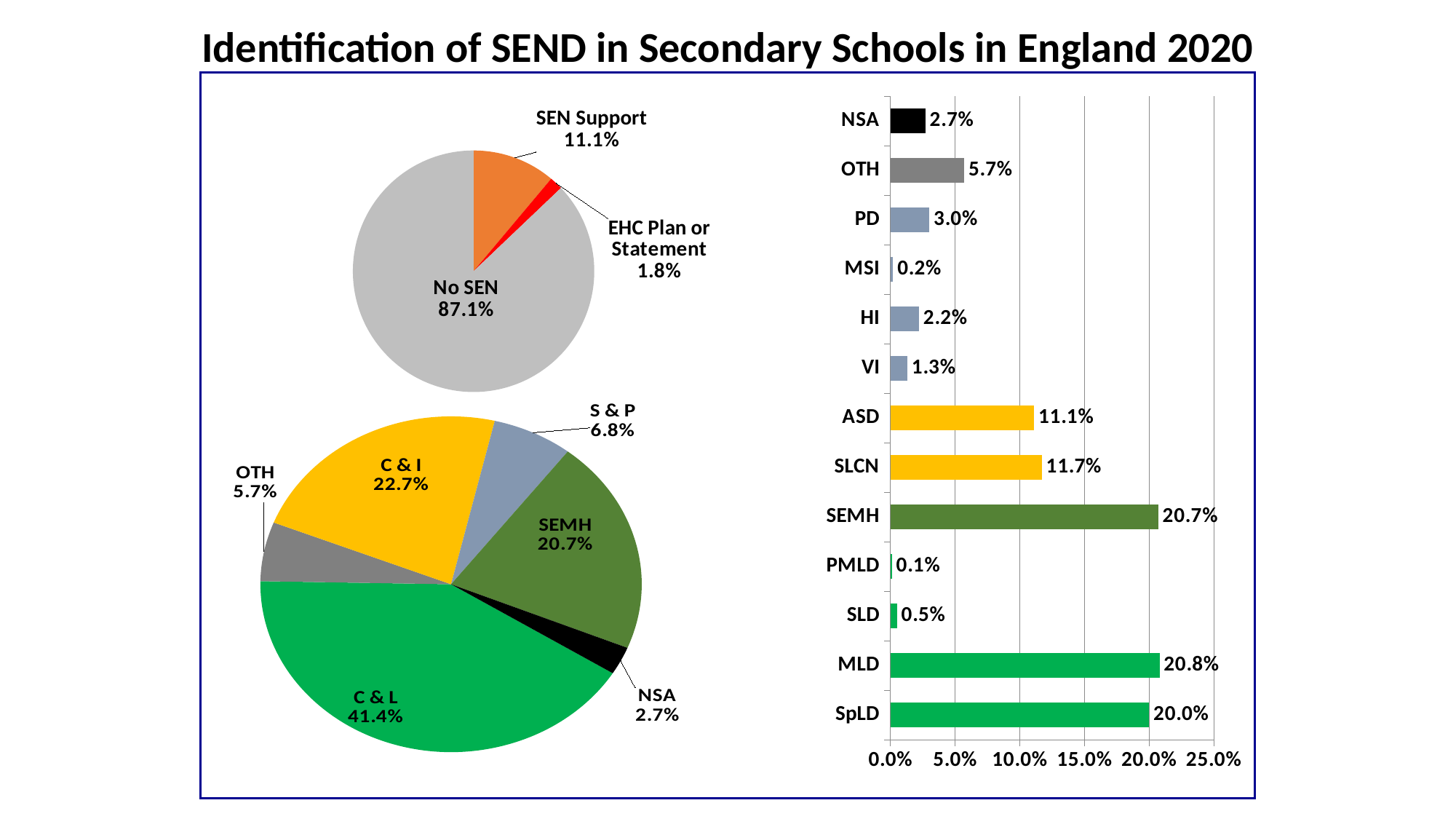
What kind of chart is shown on the right side of the slide? Bar chart In the bar chart on the right, which category has the highest value? MLD In the bottom-left pie chart, what is the difference between C & L and SEMH? 20.7% In the bar chart on the right, how many categories are shown? 13 In the bottom-left pie chart, what is the value for C & I? 22.7% In the top-left pie chart, what percentage of pupils have No SEN? 87.1% In the top-left pie chart, what is the share for EHC Plan or Statement? 1.8% In the bottom-left pie chart, which category has the largest slice? C & L In the bar chart on the right, which category has the lowest value? PMLD In the top-left pie chart, how many slices are there? 3 In the bottom-left pie chart, which is larger, S & P or OTH? S & P In the bar chart on the right, what is the value for SLCN? 11.7%